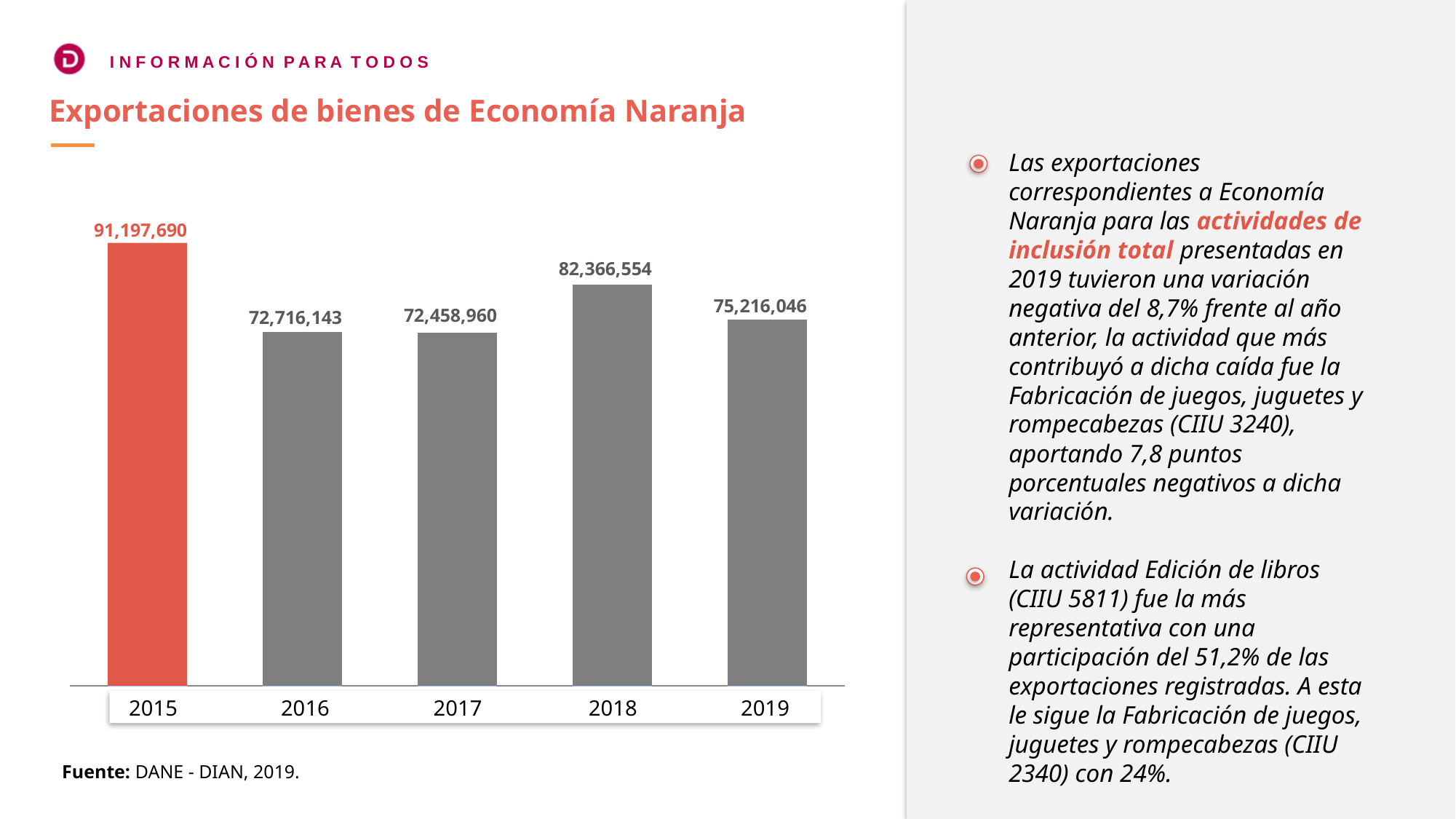
Which year has the lowest value? 2017 Which year has the highest value? 2015 What is the difference between the values for 2015 and 2016? 18,481,547 What is the value shown for 2019? 75,216,046 What kind of chart is shown on the slide? Bar chart What is the difference between the values for 2018 and 2019? 7,150,508 What is the value shown for 2018? 82,366,554 What is the value shown for 2016? 72,716,143 Did the value rise or fall from 2018 to 2019? Fall Which is larger, the value for 2017 or the value for 2019? 2019 What is the value shown for 2015? 91,197,690 How many years are shown on the x axis? 5